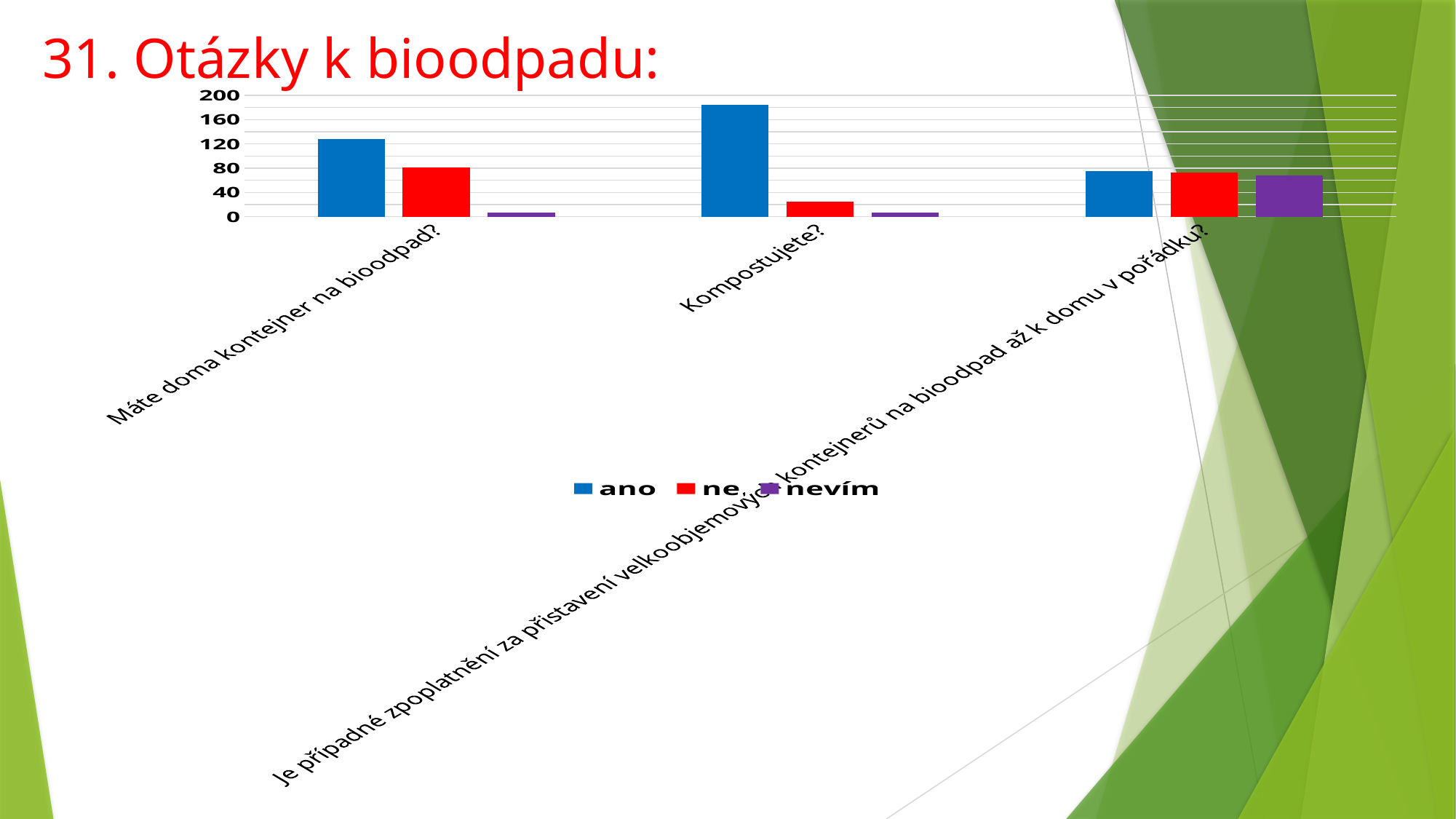
Which series is represented by the blue bars? ano How many series does the legend list? 3 For 'Kompostujete?', which series has the highest value? ano For which question category is the 'ano' bar the highest? Kompostujete? What is the title of the slide containing the chart? 31. Otázky k bioodpadu: For 'Máte doma kontejner na bioodpad?', which is larger: 'ano' or 'ne'? ano What kind of chart is shown on the slide? bar chart Is the 'ano' value for 'Kompostujete?' greater or less than 160? greater How many question categories are shown on the x axis? 3 Is the 'ne' value for 'Kompostujete?' greater or less than 40? less Is the 'ano' value for 'Máte doma kontejner na bioodpad?' greater or less than 160? less For 'Máte doma kontejner na bioodpad?', which series has the lowest value? nevím